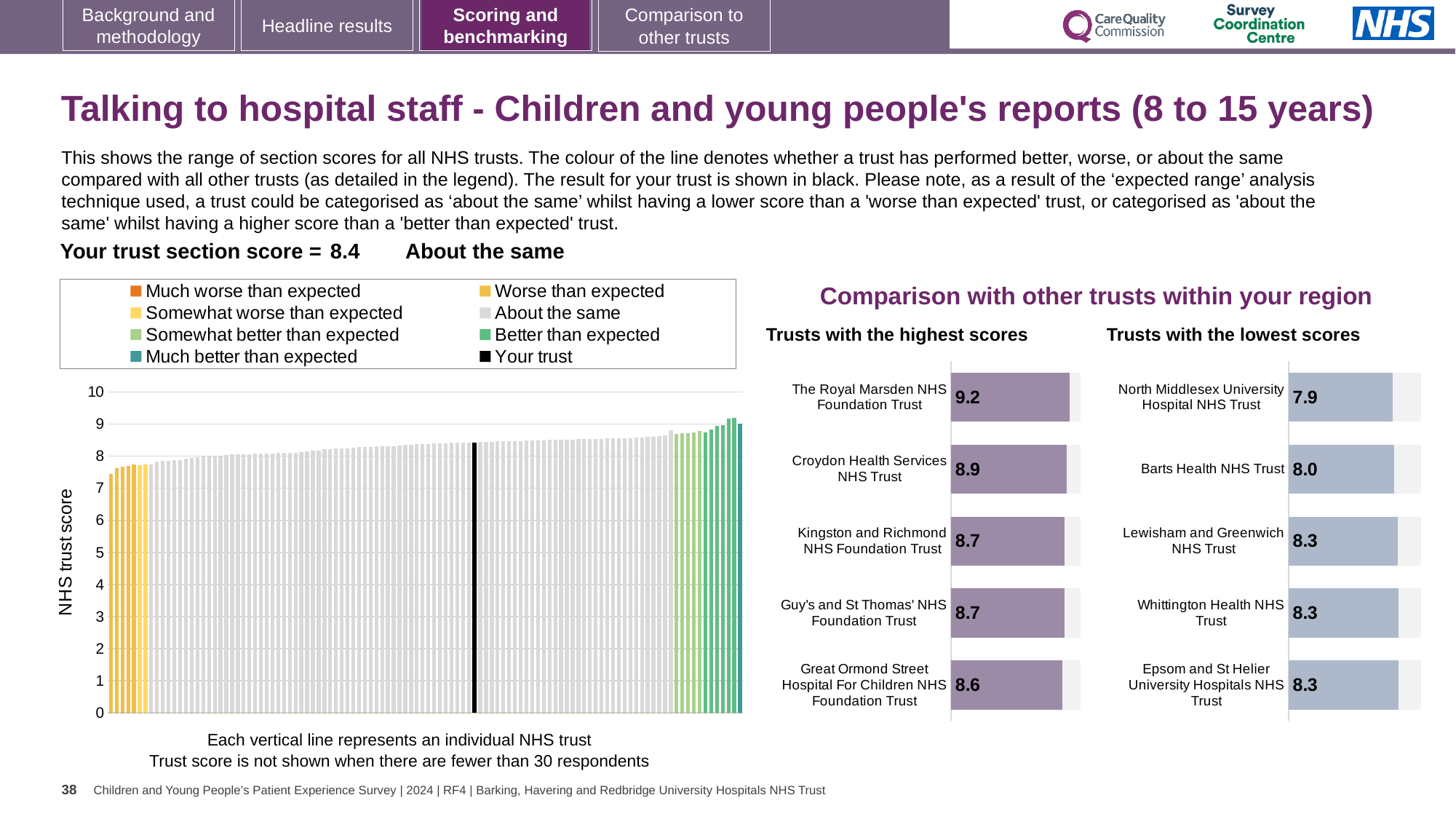
In the 'Trusts with the lowest scores' chart, what is the score for North Middlesex University Hospital NHS Trust? 7.9 What kind of chart is the main 'NHS trust score' chart on the left? Bar chart In the 'Trusts with the lowest scores' chart, which trust has the lowest score? North Middlesex University Hospital NHS Trust In the main NHS trust score chart, what colour represents 'Your trust'? Black In the 'Trusts with the highest scores' chart, what is the difference between the scores of The Royal Marsden NHS Foundation Trust and Great Ormond Street Hospital For Children NHS Foundation Trust? 0.6 In the 'Trusts with the highest scores' chart, what is the score for Croydon Health Services NHS Trust? 8.9 In the 'Trusts with the highest scores' chart, what is the score for The Royal Marsden NHS Foundation Trust? 9.2 In the 'Trusts with the highest scores' chart, which trust has the highest score? The Royal Marsden NHS Foundation Trust How many entries does the legend of the main NHS trust score chart list? 8 How many trusts are listed in the 'Trusts with the lowest scores' chart? 5 Which has the higher score: Croydon Health Services NHS Trust in the highest scores chart or Barts Health NHS Trust in the lowest scores chart? Croydon Health Services NHS Trust In the main NHS trust score chart, is the value for the black 'Your trust' bar greater or less than 8? greater